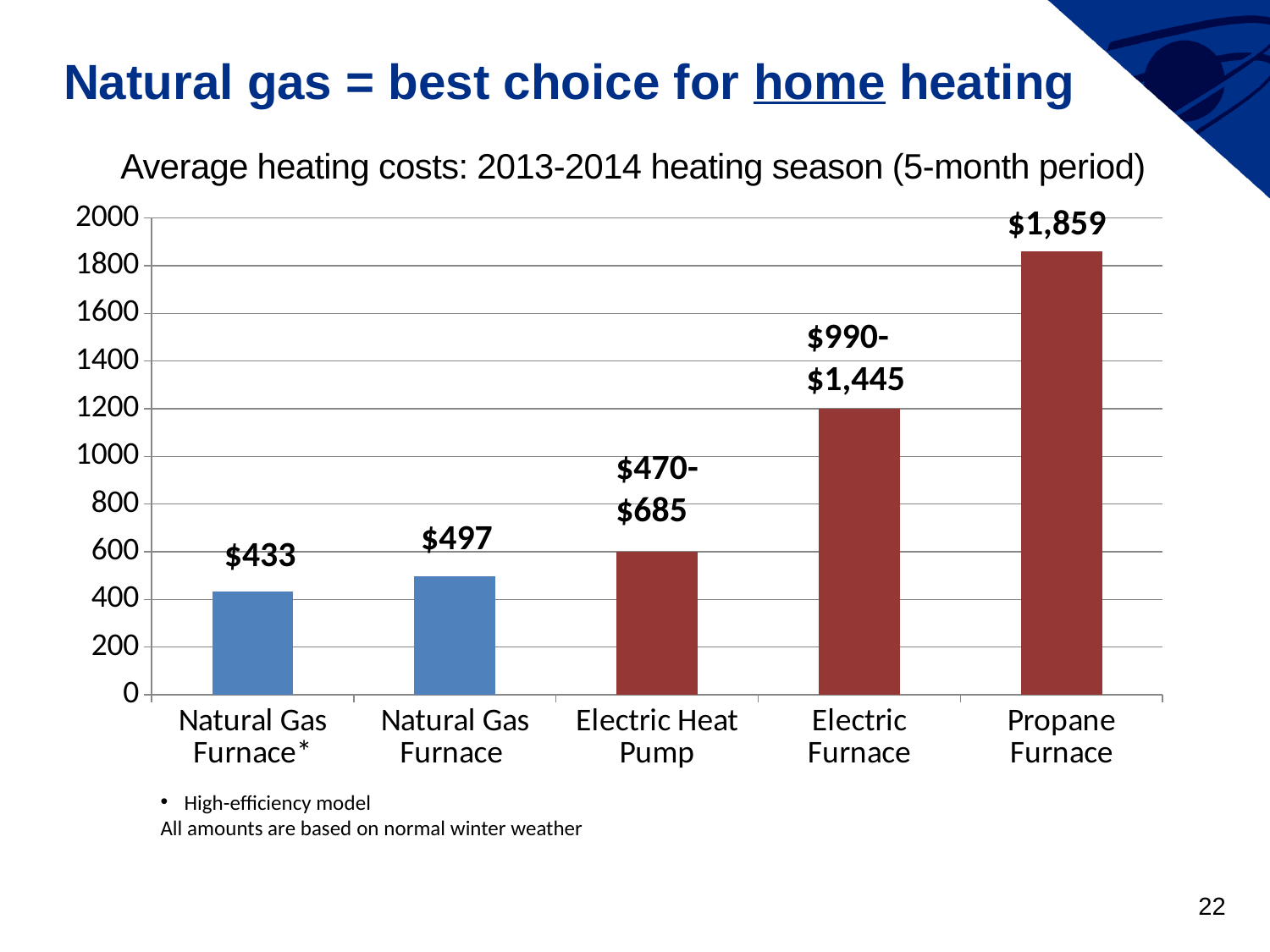
What type of chart is shown on the slide? bar chart What cost range is labelled for the Electric Heat Pump? $470-$685 What is the average heating cost shown for the Propane Furnace? $1,859 Is the bar for the Electric Heat Pump greater or less than 800? less Which heating option has the lowest average heating cost? Natural Gas Furnace* How much more does the Natural Gas Furnace cost than the Natural Gas Furnace* (high-efficiency model)? $64 What is the average heating cost shown for the Natural Gas Furnace? $497 Which has the higher heating cost, the Propane Furnace or the Electric Furnace? Propane Furnace Which heating option has the highest average heating cost? Propane Furnace How many heating options are shown in the chart? 5 What is the average heating cost shown for the Natural Gas Furnace* (high-efficiency model)? $433 What cost range is labelled for the Electric Furnace? $990-$1,445